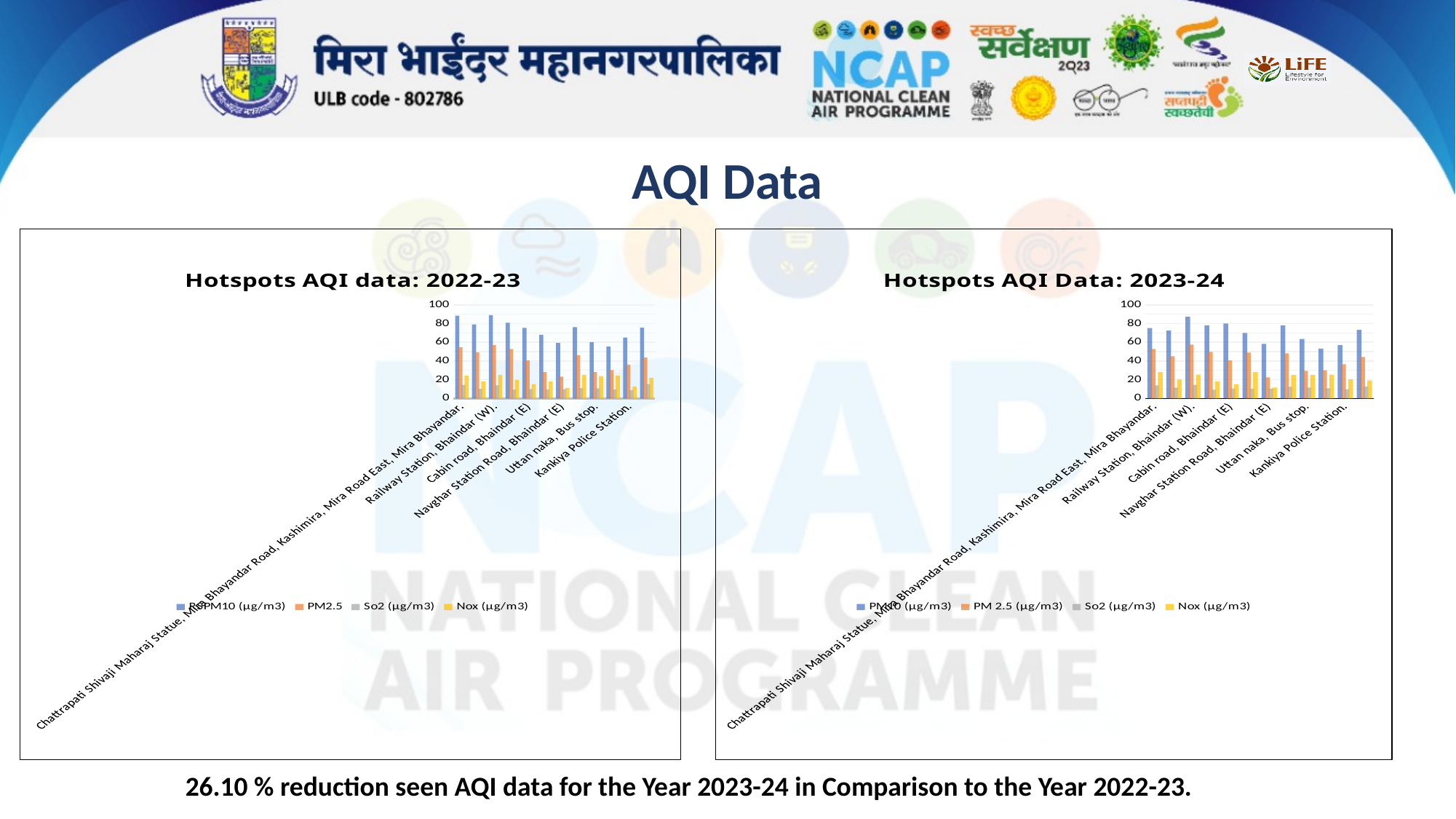
How many series does the legend of the 'Hotspots AQI data: 2022-23' chart list? 4 What is the title of the chart on the right side of the slide? Hotspots AQI Data: 2023-24 What kind of chart is the 'Hotspots AQI data: 2022-23' chart? Bar chart In the 'Hotspots AQI data: 2022-23' chart, which series is larger at every location, PM10 or PM2.5? PM10 In the 'Hotspots AQI data: 2022-23' chart, is the highest PM10 value greater or less than 80? greater What is the maximum value shown on the vertical axis of the 'Hotspots AQI Data: 2023-24' chart? 100 In the 'Hotspots AQI Data: 2023-24' chart, is the highest So2 value greater or less than 20? less In the 'Hotspots AQI Data: 2023-24' chart, is the highest PM10 value greater or less than 80? greater In the 'Hotspots AQI data: 2022-23' chart, which series has the tallest bars at every location? RSPM10 (µg/m3) In the 'Hotspots AQI Data: 2023-24' chart, which series has the smallest bars at every location? So2 (µg/m3) How many series does the legend of the 'Hotspots AQI Data: 2023-24' chart list? 4